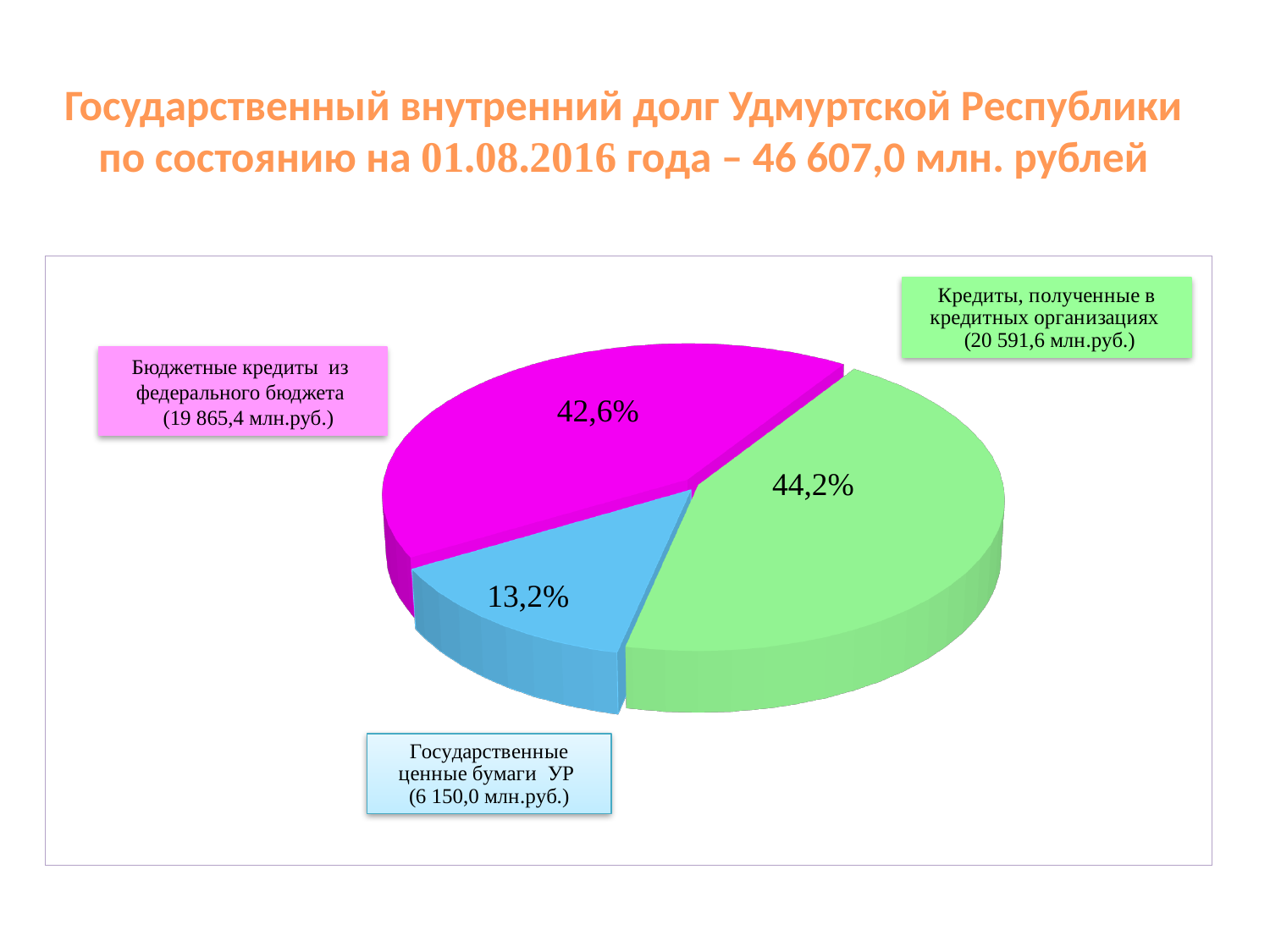
What type of chart is shown on the slide? Pie chart What share of the pie does the slice for Бюджетные кредиты из федерального бюджета represent? 42,6% What amount in млн.руб. is shown for Кредиты, полученные в кредитных организациях? 20 591,6 млн.руб. How many slices does the pie chart have? 3 Which is larger: the share for Бюджетные кредиты из федерального бюджета or the share for Государственные ценные бумаги УР? Бюджетные кредиты из федерального бюджета What share of the pie does the slice for Государственные ценные бумаги УР represent? 13,2% What is the difference in percentage points between the share for Кредиты, полученные в кредитных организациях and the share for Бюджетные кредиты из федерального бюджета? 1,6 percentage points What share of the pie does the slice for Кредиты, полученные в кредитных организациях represent? 44,2% What amount in млн.руб. is shown for Бюджетные кредиты из федерального бюджета? 19 865,4 млн.руб. Which category has the smallest share of the pie? Государственные ценные бумаги УР Which category has the largest share of the pie? Кредиты, полученные в кредитных организациях What amount in млн.руб. is shown for Государственные ценные бумаги УР? 6 150,0 млн.руб.